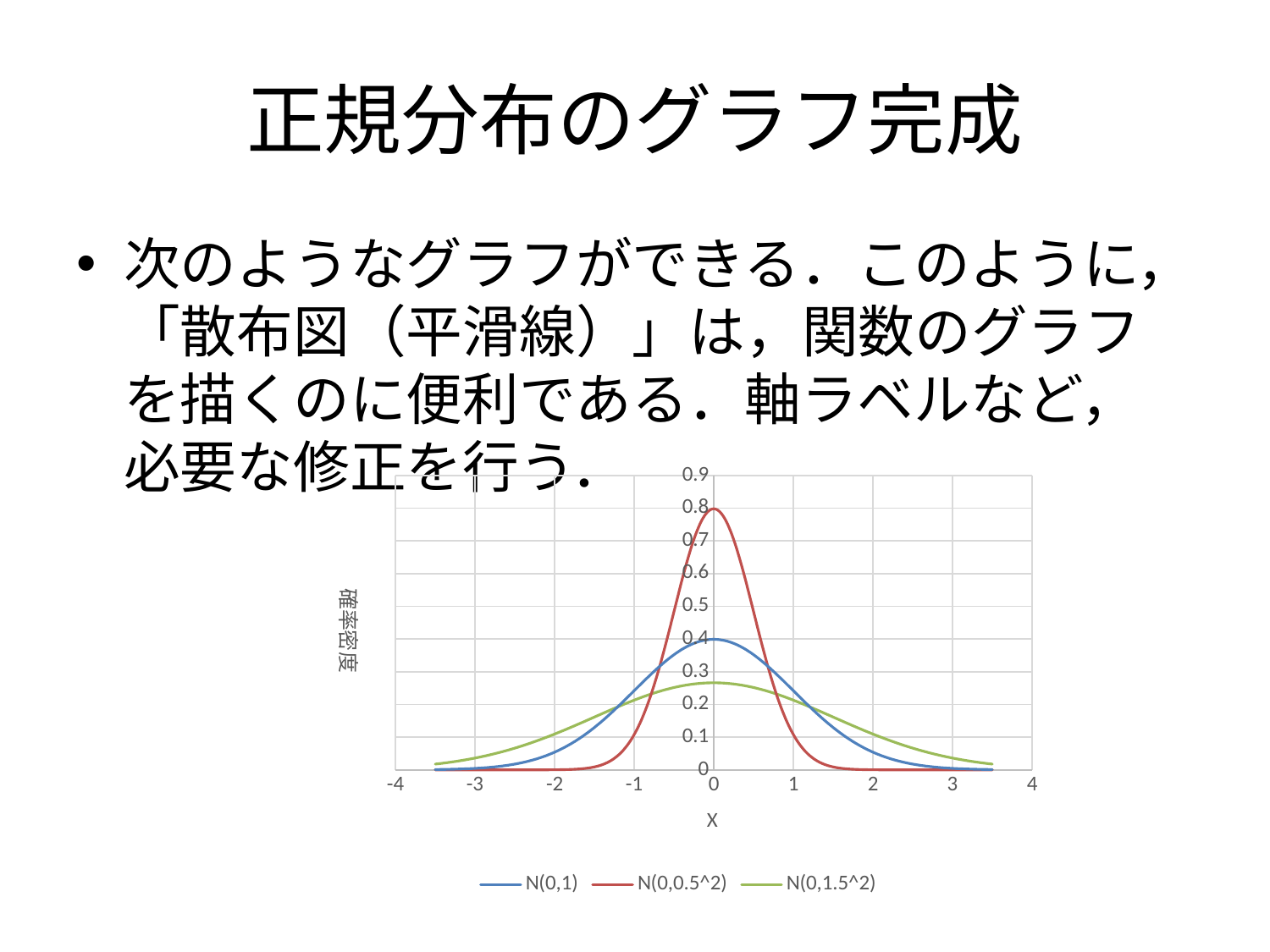
Which series has the lowest peak value? N(0,1.5^2) Which series is drawn in red? N(0,0.5^2) At x = 0, which is larger: the value of N(0,1) or the value of N(0,1.5^2)? N(0,1) How many series does the legend list? 3 Which series reaches the highest peak value? N(0,0.5^2) What is the label on the vertical axis of the chart? 確率密度 Is the peak value of the N(0,0.5^2) curve greater or less than 0.7? greater Is the peak value of the N(0,1.5^2) curve greater or less than 0.2? greater What kind of chart is shown on the slide? line chart Do the values of the N(0,0.5^2) curve rise or fall as x goes from 0 to 3? fall Is the peak value of the N(0,1.5^2) curve greater or less than 0.3? less